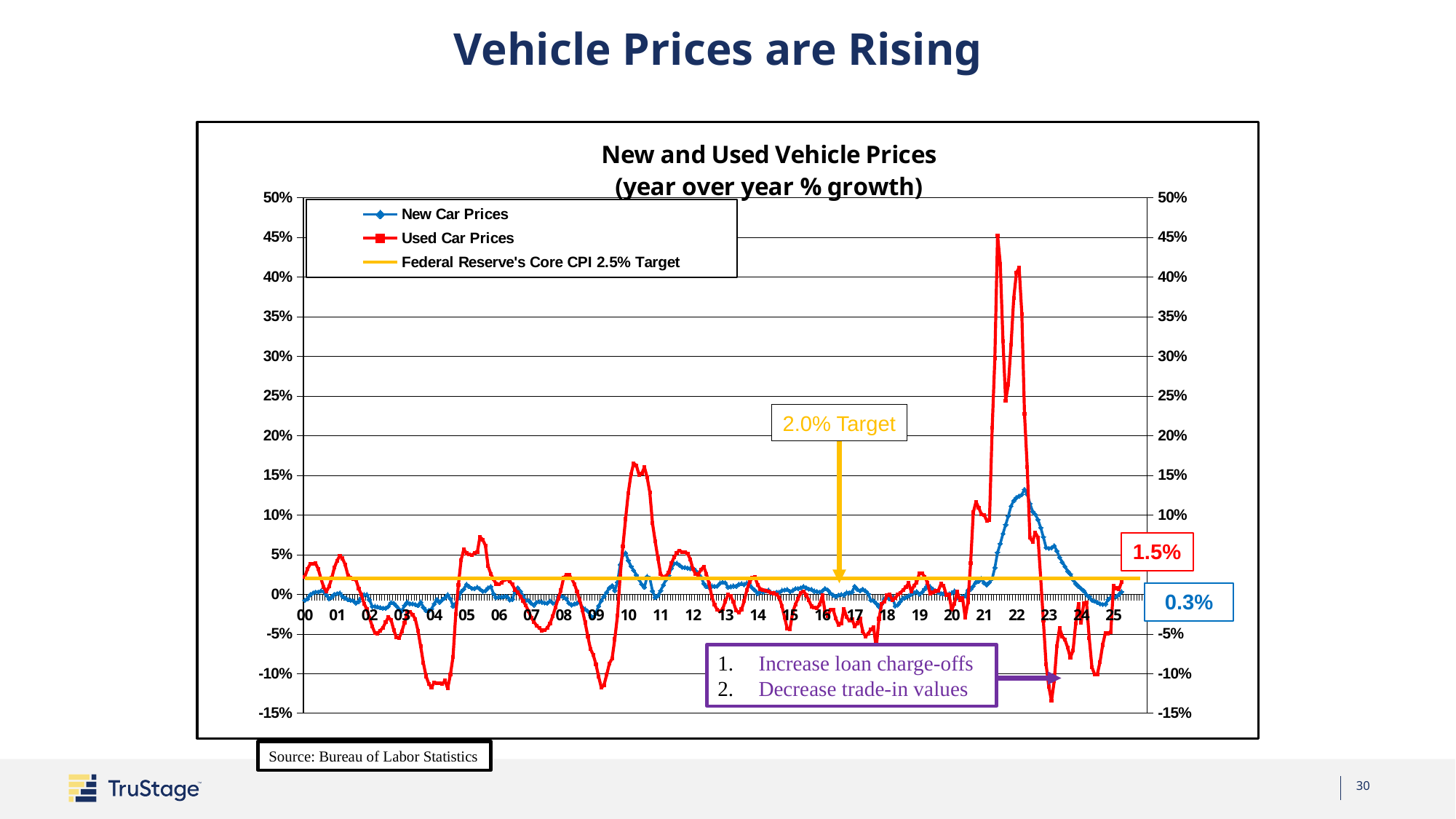
How many series does the legend list? 3 What source is cited for the chart data? Bureau of Labor Statistics Is the lowest point of Used Car Prices around 2023 greater or less than -10%? less Which is larger at the end of the chart, the labeled Used Car Prices value or the labeled New Car Prices value? Used Car Prices What is the latest labeled year-over-year growth value for Used Car Prices? 1.5% What is the title of the chart? New and Used Vehicle Prices (year over year % growth) What is the latest labeled year-over-year growth value for New Car Prices? 0.3% What is the difference between the labeled latest Used Car Prices value (1.5%) and the labeled latest New Car Prices value (0.3%)? 1.2 percentage points Which series reaches the highest value on the chart? Used Car Prices Is the peak of Used Car Prices around 2021 greater or less than 40%? greater Is the peak of New Car Prices around 2022 greater or less than 15%? less What kind of chart is shown on the slide? line chart